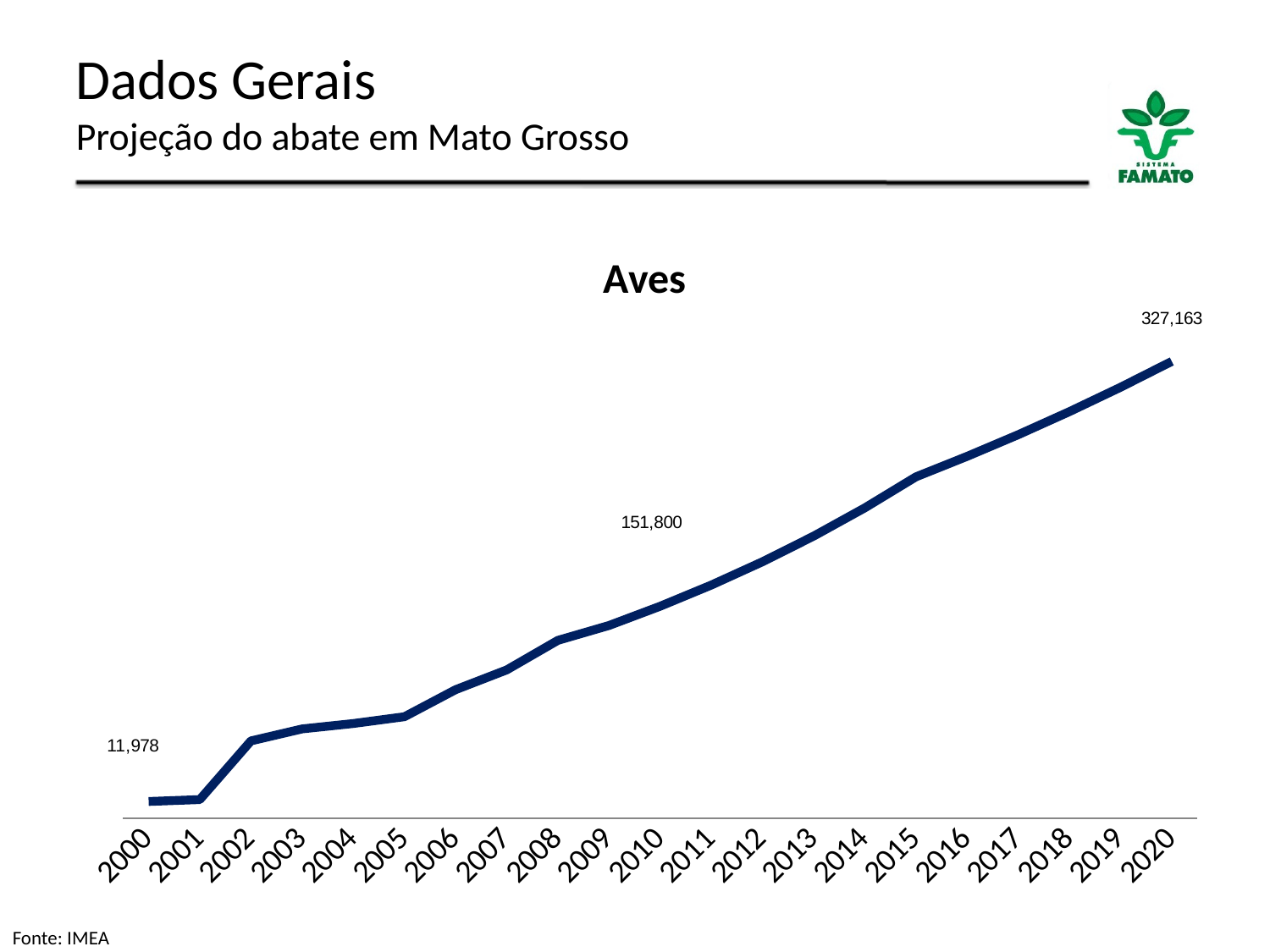
Do the values in the Aves chart rise or fall from 2000 to 2020? Rise What is the difference between the values for 2020 and 2000 in the Aves chart? 315,185 What is the difference between the values for 2020 and 2010 in the Aves chart? 175,363 Which year has the lowest value in the Aves chart? 2000 What is the difference between the values for 2010 and 2000 in the Aves chart? 139,822 What kind of chart is shown on the slide? Line chart Which is larger in the Aves chart, the value for 2005 or the value for 2015? 2015 What is the value for 2010 in the Aves chart? 151,800 Which year has the highest value in the Aves chart? 2020 What is the value for 2000 in the Aves chart? 11,978 How many years are plotted on the x axis of the Aves chart? 21 What is the value for 2020 in the Aves chart? 327,163